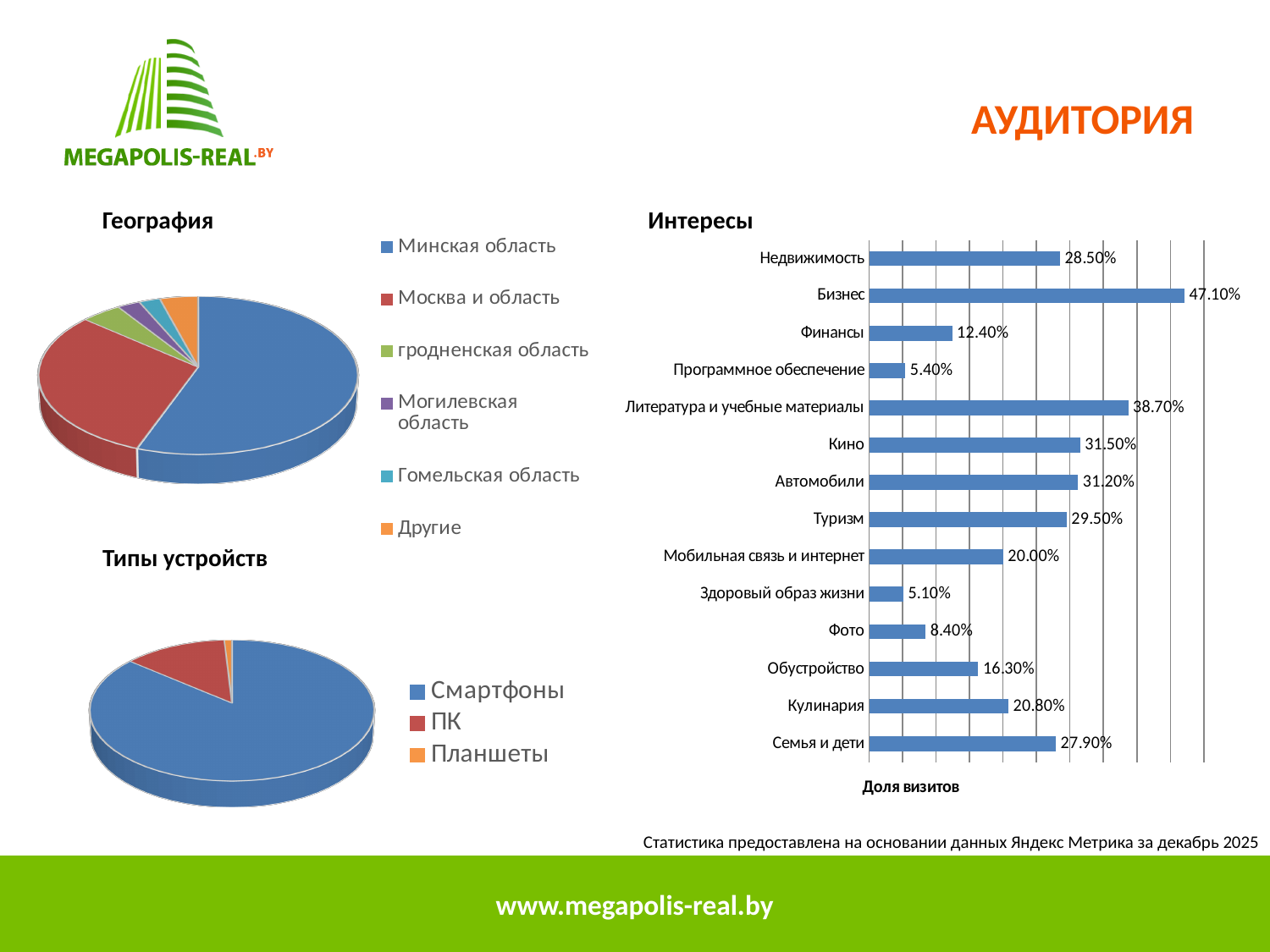
How many categories are shown in the 'Интересы' chart? 14 In the 'Интересы' chart, which category has the highest value? Бизнес In the 'Интересы' chart, which is larger: the value for Туризм or the value for Кулинария? Туризм In the 'Интересы' chart, what is the difference between the values for Бизнес and Недвижимость? 18.60% In the 'Типы устройств' chart, which category has the largest slice? Смартфоны In the 'Интересы' chart, what is the value for Литература и учебные материалы? 38.70% What kind of chart is the 'География' chart? pie chart What kind of chart is the 'Интересы' chart? bar chart In the 'Интересы' chart, what is the value for Бизнес? 47.10% How many entries does the legend of the 'География' chart list? 6 In the 'Интересы' chart, what is the value for Здоровый образ жизни? 5.10% In the 'Интересы' chart, which category has the lowest value? Здоровый образ жизни